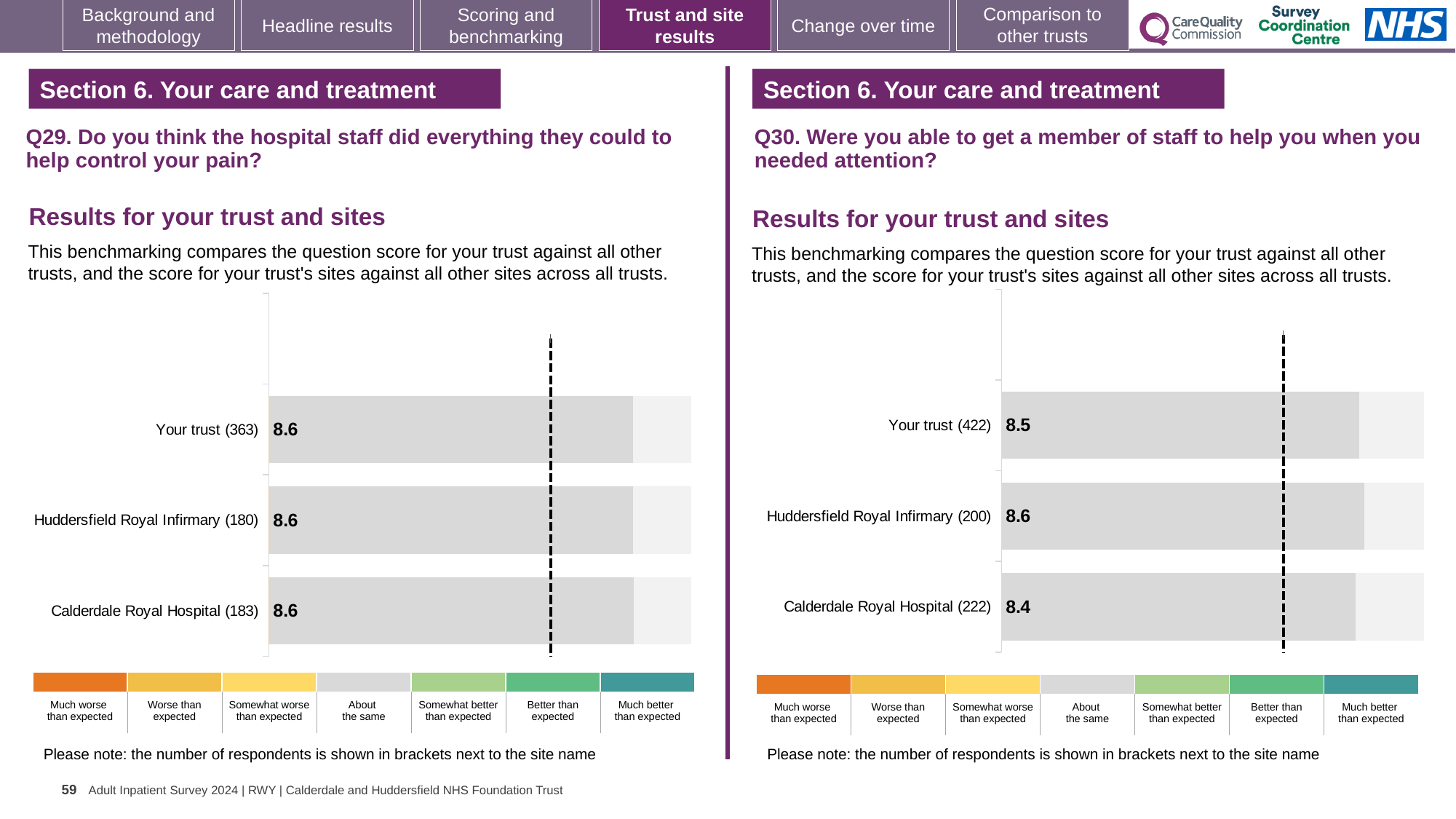
In the Q30 chart on the right, what is the score for Your trust (422)? 8.5 In the Q30 chart on the right, which site or trust has the lowest score? Calderdale Royal Hospital (222) In the Q29 chart on the left, what is the score for Calderdale Royal Hospital (183)? 8.6 How many bars are shown in the Q29 chart on the left? 3 In the Q30 chart on the right, what is the difference between the scores for Huddersfield Royal Infirmary (200) and Calderdale Royal Hospital (222)? 0.2 What type of chart is used for the Q30 results on the right? Bar chart In the Q30 chart on the right, which site or trust has the highest score? Huddersfield Royal Infirmary (200) In the Q29 chart on the left, what is the score for Your trust (363)? 8.6 In the Q30 chart on the right, what is the score for Calderdale Royal Hospital (222)? 8.4 How many respondents are shown in brackets for Huddersfield Royal Infirmary in the Q29 chart on the left? 180 In the Q30 chart on the right, which has the larger score: Your trust (422) or Calderdale Royal Hospital (222)? Your trust (422) In the Q30 chart on the right, what is the score for Huddersfield Royal Infirmary (200)? 8.6